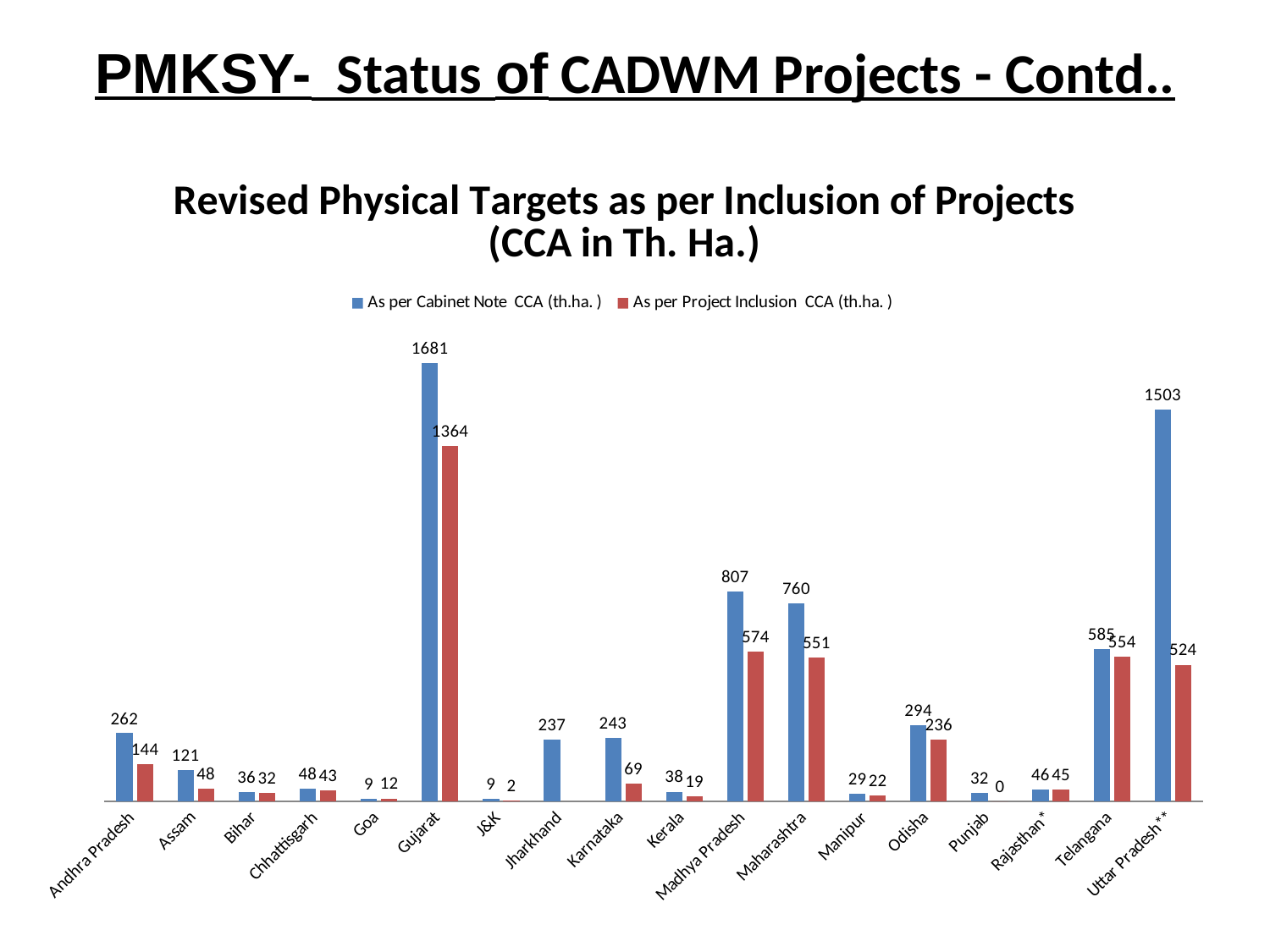
How many series does the chart's legend list? 2 What is the difference between the 'As per Cabinet Note' and 'As per Project Inclusion' values for Uttar Pradesh**? 979 For Goa, which series has the larger value, 'As per Cabinet Note' or 'As per Project Inclusion'? As per Project Inclusion What is the value for Goa in the 'As per Project Inclusion CCA (th.ha. )' series? 12 Which has the larger 'As per Cabinet Note CCA (th.ha. )' value, Madhya Pradesh or Maharashtra? Madhya Pradesh Which state has the lowest value in the 'As per Project Inclusion CCA (th.ha. )' series? Punjab What is the difference between the 'As per Cabinet Note' and 'As per Project Inclusion' values for Gujarat? 317 What is the value for Gujarat in the 'As per Cabinet Note CCA (th.ha. )' series? 1681 What is the value for Uttar Pradesh** in the 'As per Project Inclusion CCA (th.ha. )' series? 524 What kind of chart is shown on the slide? Bar chart Which state has the highest value in the 'As per Cabinet Note CCA (th.ha. )' series? Gujarat How many states are shown on the x axis of the chart? 18